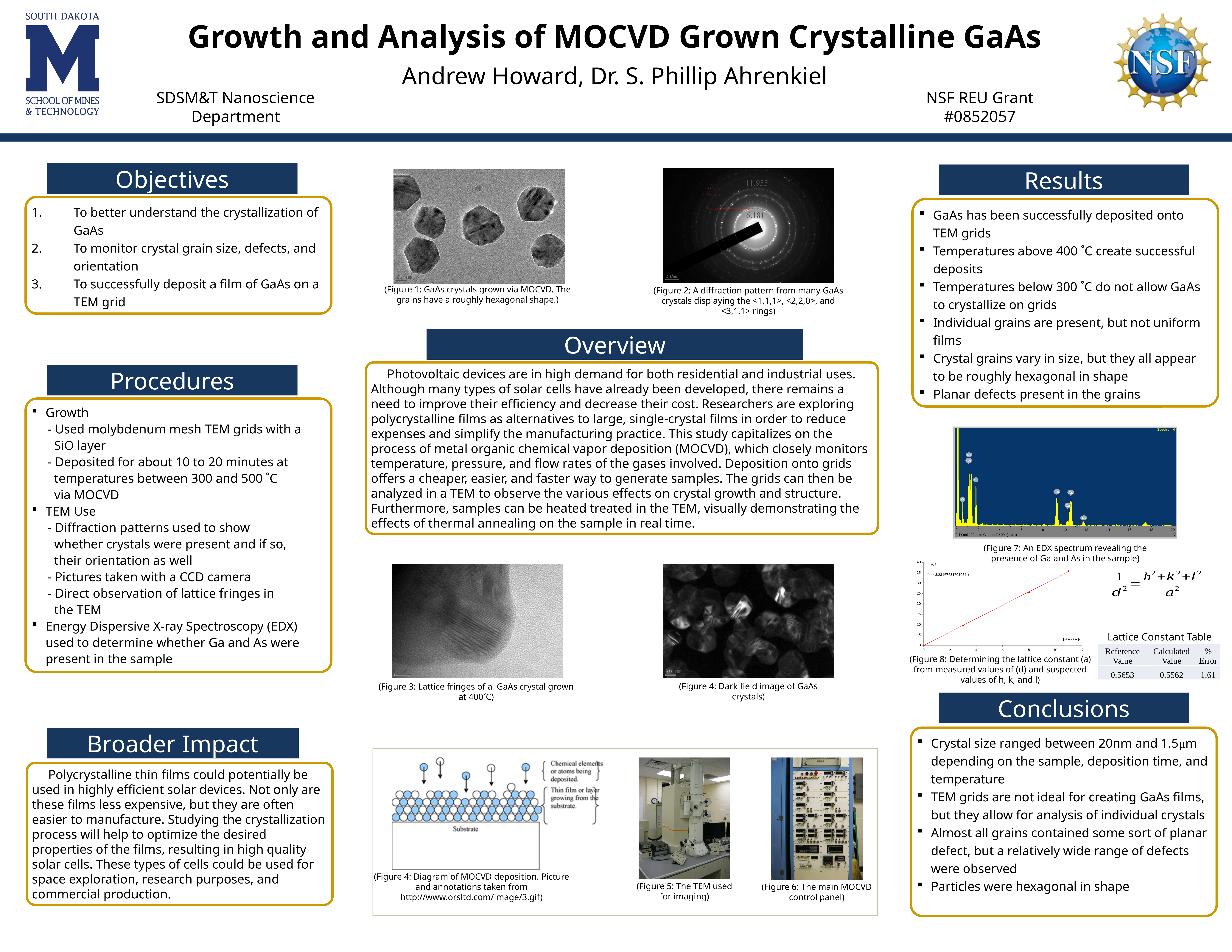
In the Lattice Constant Table, which is larger, the Reference Value or the Calculated Value? Reference Value In Figure 8, do the plotted values rise or fall as h²+k²+l² increases along the x axis? rise In the Lattice Constant Table, what is the Calculated Value? 0.5562 How many data points are plotted in Figure 8? 4 In Figure 8, is the 1/d² value at h²+k²+l² = 8 greater or less than 20? greater In Figure 8, is the 1/d² value at h²+k²+l² = 8 greater or less than 30? less What kind of chart is Figure 8? scatter chart with a trend line What unit is shown on the x axis of the EDX spectrum in Figure 7? keV In the Lattice Constant Table, what is the Reference Value? 0.5653 In Figure 8, is the 1/d² value at h²+k²+l² = 11 greater or less than 30? greater What is the highest tick value shown on the y axis of Figure 8? 40 In Figure 8, which plotted point has the highest 1/d² value, the one at h²+k²+l² = 3, 8, or 11? 11